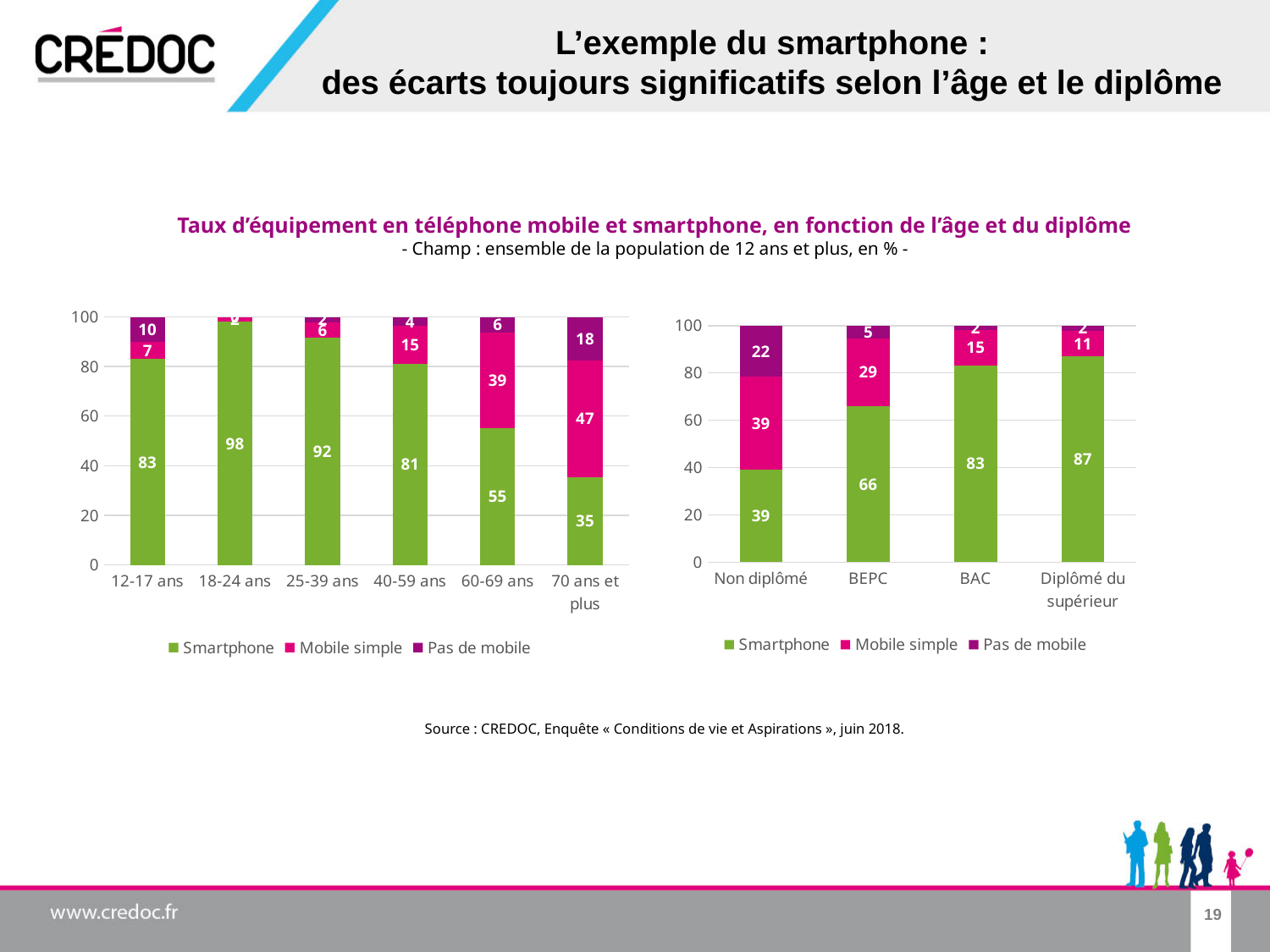
In the left chart (by age), how many age groups are shown on the x axis? 6 In the right chart (by diploma), what is the Pas de mobile value for Non diplômé? 22 In the right chart (by diploma), is the Smartphone value for BAC or for BEPC larger? BAC In the right chart (by diploma), how many series does the legend list? 3 In the left chart (by age), which age group has the highest Smartphone value? 18-24 ans In the right chart (by diploma), what is the Mobile simple value for BEPC? 29 In the left chart (by age), what is the Smartphone value for 12-17 ans? 83 In the left chart (by age), which age group has the lowest Smartphone value? 70 ans et plus In the left chart (by age), what is the Mobile simple value for 70 ans et plus? 47 In the left chart (by age), what is the difference between the Smartphone values for 60-69 ans and 70 ans et plus? 20 In the right chart (by diploma), which category has the highest Smartphone value? Diplômé du supérieur What kind of chart is the left chart (by age)? Stacked bar chart